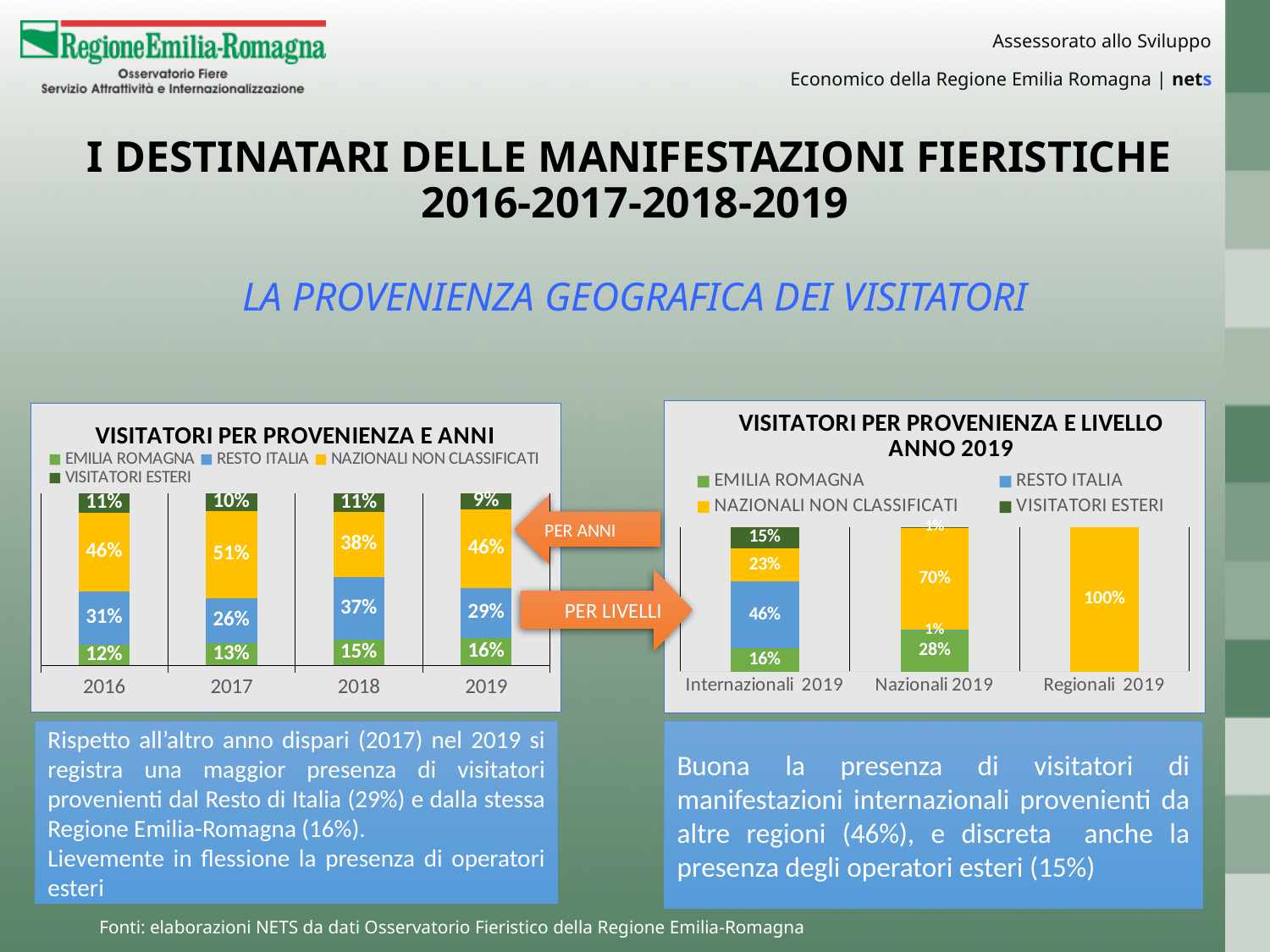
In the chart 'VISITATORI PER PROVENIENZA E LIVELLO ANNO 2019', which is larger: the EMILIA ROMAGNA value for Internazionali 2019 or for Nazionali 2019? Nazionali 2019 In the chart 'VISITATORI PER PROVENIENZA E ANNI', does the EMILIA ROMAGNA value rise or fall from 2016 to 2019? rise In the chart 'VISITATORI PER PROVENIENZA E LIVELLO ANNO 2019', how many series does the legend list? 4 In the chart 'VISITATORI PER PROVENIENZA E ANNI', what is the value for NAZIONALI NON CLASSIFICATI in 2017? 51% In the chart 'VISITATORI PER PROVENIENZA E ANNI', which year has the highest value for EMILIA ROMAGNA? 2019 In the chart 'VISITATORI PER PROVENIENZA E LIVELLO ANNO 2019', what is the value for RESTO ITALIA for Internazionali 2019? 46% In the chart 'VISITATORI PER PROVENIENZA E ANNI', what is the difference between the RESTO ITALIA values for 2018 and 2017? 11% What kind of chart is 'VISITATORI PER PROVENIENZA E LIVELLO ANNO 2019'? stacked bar chart In the chart 'VISITATORI PER PROVENIENZA E ANNI', how many years are shown on the x axis? 4 In the chart 'VISITATORI PER PROVENIENZA E LIVELLO ANNO 2019', what is the value for NAZIONALI NON CLASSIFICATI for Nazionali 2019? 70% In the chart 'VISITATORI PER PROVENIENZA E ANNI', which year has the lowest value for VISITATORI ESTERI? 2019 In the chart 'VISITATORI PER PROVENIENZA E ANNI', what is the value for RESTO ITALIA in 2018? 37%